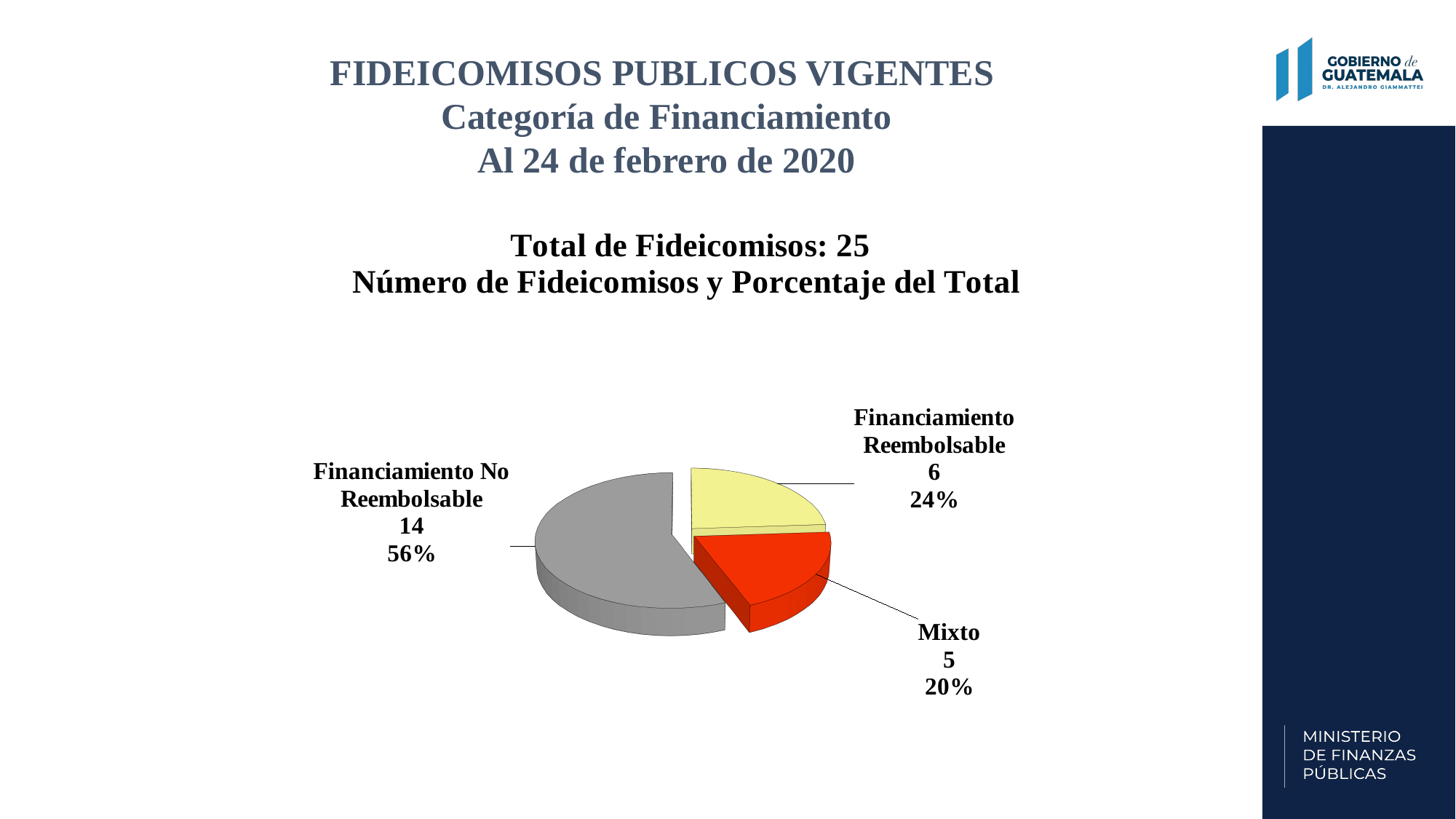
How many categories are shown in the pie chart? 3 What colour is the slice for Mixto? Red Which category has the largest number of fideicomisos? Financiamiento No Reembolsable What is the difference in the number of fideicomisos between Financiamiento No Reembolsable and Financiamiento Reembolsable? 8 Which category has the smallest number of fideicomisos? Mixto What type of chart is shown on the slide? Pie chart How many fideicomisos are in the Mixto category? 5 Which has more fideicomisos, Financiamiento Reembolsable or Mixto? Financiamiento Reembolsable How many fideicomisos are in the Financiamiento No Reembolsable category? 14 What percentage of the total does Financiamiento Reembolsable represent? 24% What percentage of the total does Mixto represent? 20% What is the total number of fideicomisos shown on the slide? 25